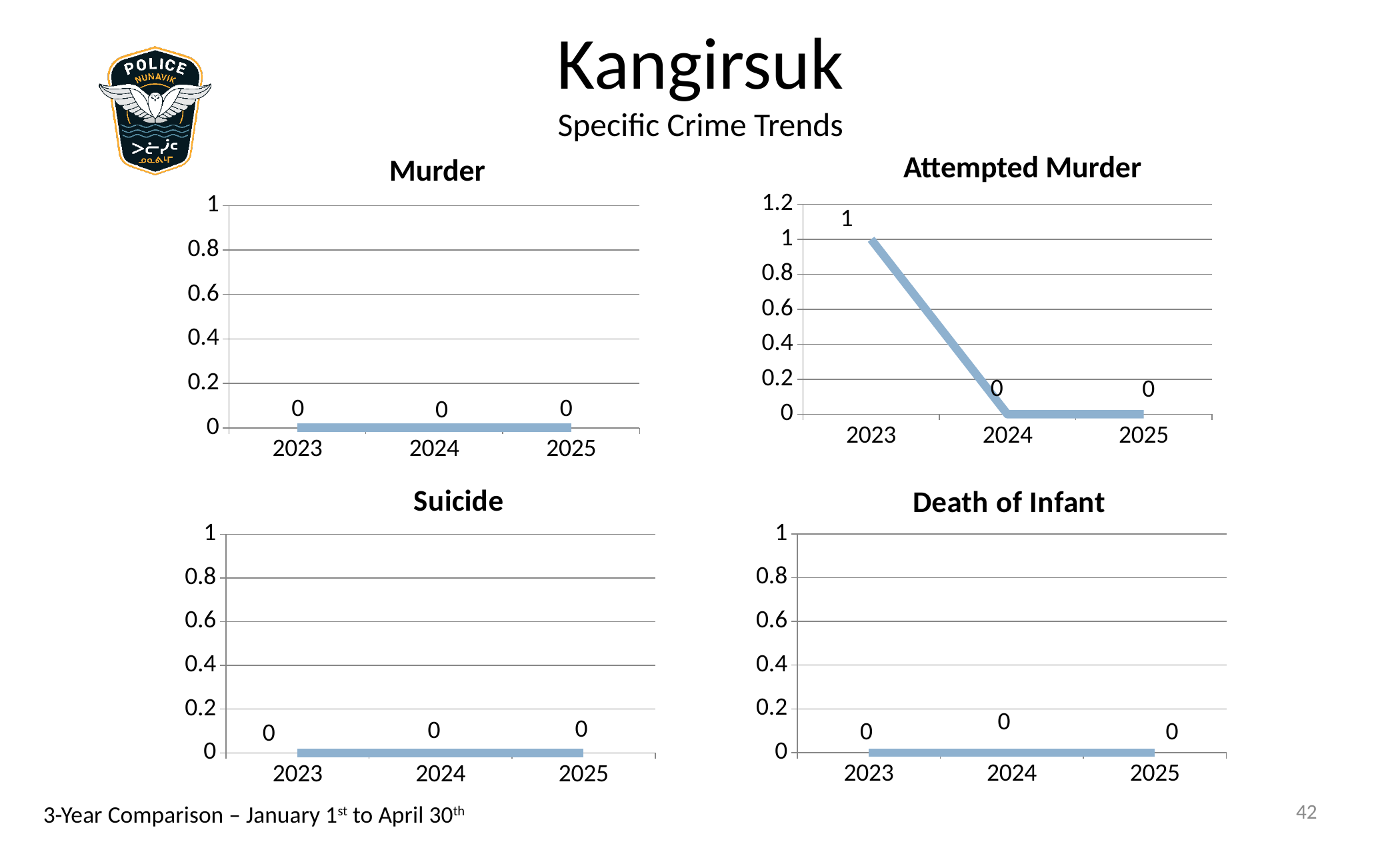
In the Suicide chart, what is the value for 2025? 0 In the Attempted Murder chart, is the value for 2023 larger than the value for 2024? yes In the Attempted Murder chart, what is the value for 2023? 1 How many years are plotted in the Suicide chart? 3 In the Attempted Murder chart, do the values rise or fall from 2023 to 2025? fall In the Attempted Murder chart, what is the value for 2024? 0 In the Murder chart, what is the value for 2024? 0 In the Attempted Murder chart, what is the difference between the 2023 and 2025 values? 1 In the Attempted Murder chart, which year has the highest value? 2023 What kind of chart is the Attempted Murder chart? line chart What is the title of the chart in the bottom right of the slide? Death of Infant In the Death of Infant chart, what is the value for 2023? 0